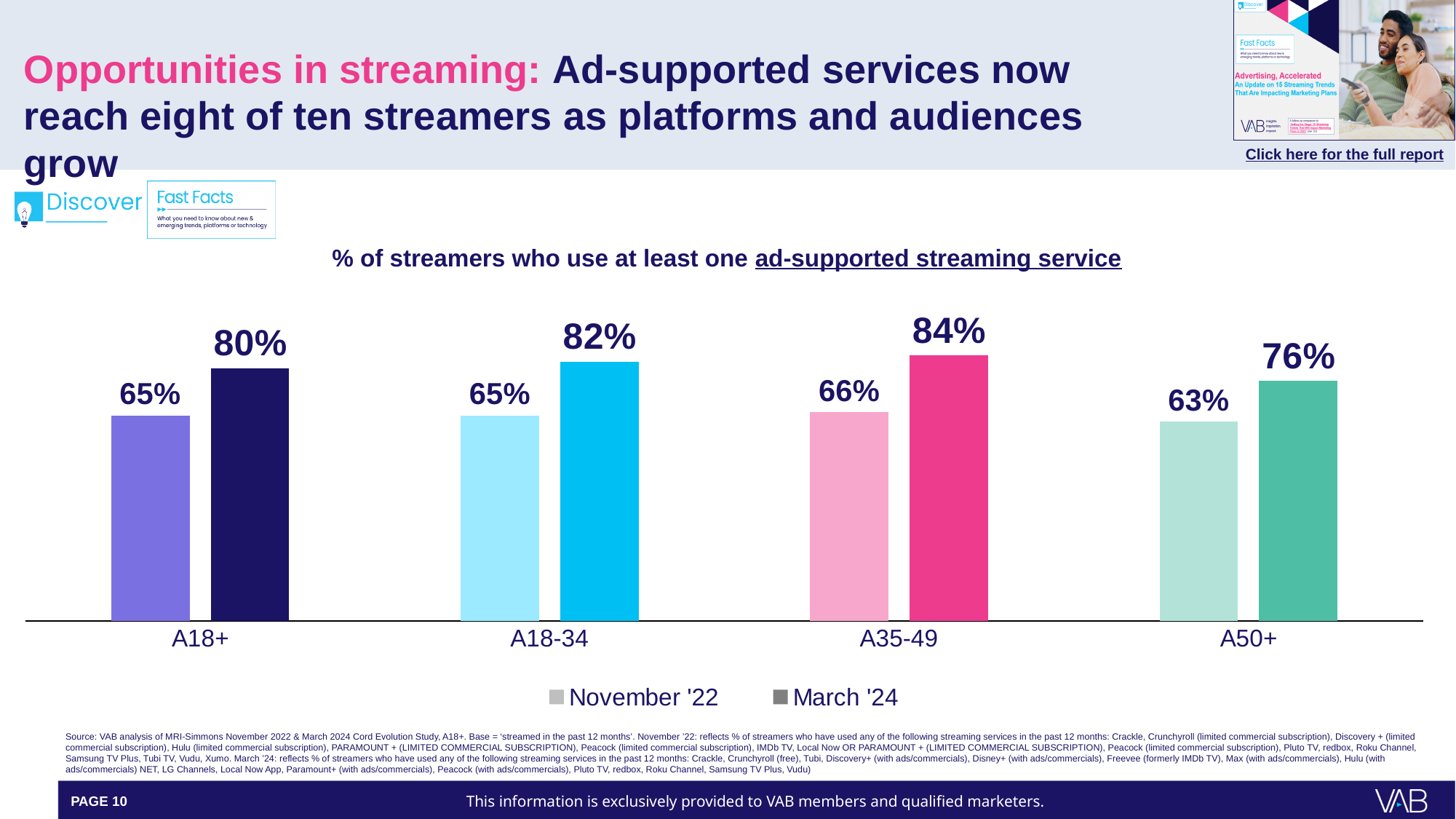
What is the March '24 value for A18+? 80% What is the difference between the March '24 and November '22 values for A18-34? 17 percentage points Which is larger: the March '24 value for A50+ or the March '24 value for A18+? A18+ How many series does the legend list? 2 What kind of chart is shown on the slide? Bar chart Which age group has the lowest November '22 value? A50+ How many age groups are shown on the x axis? 4 Which age group has the highest March '24 value? A35-49 What is the November '22 value for A50+? 63% What is the title of the chart? % of streamers who use at least one ad-supported streaming service What are the two series listed in the legend? November '22 and March '24 What is the March '24 value for A35-49? 84%